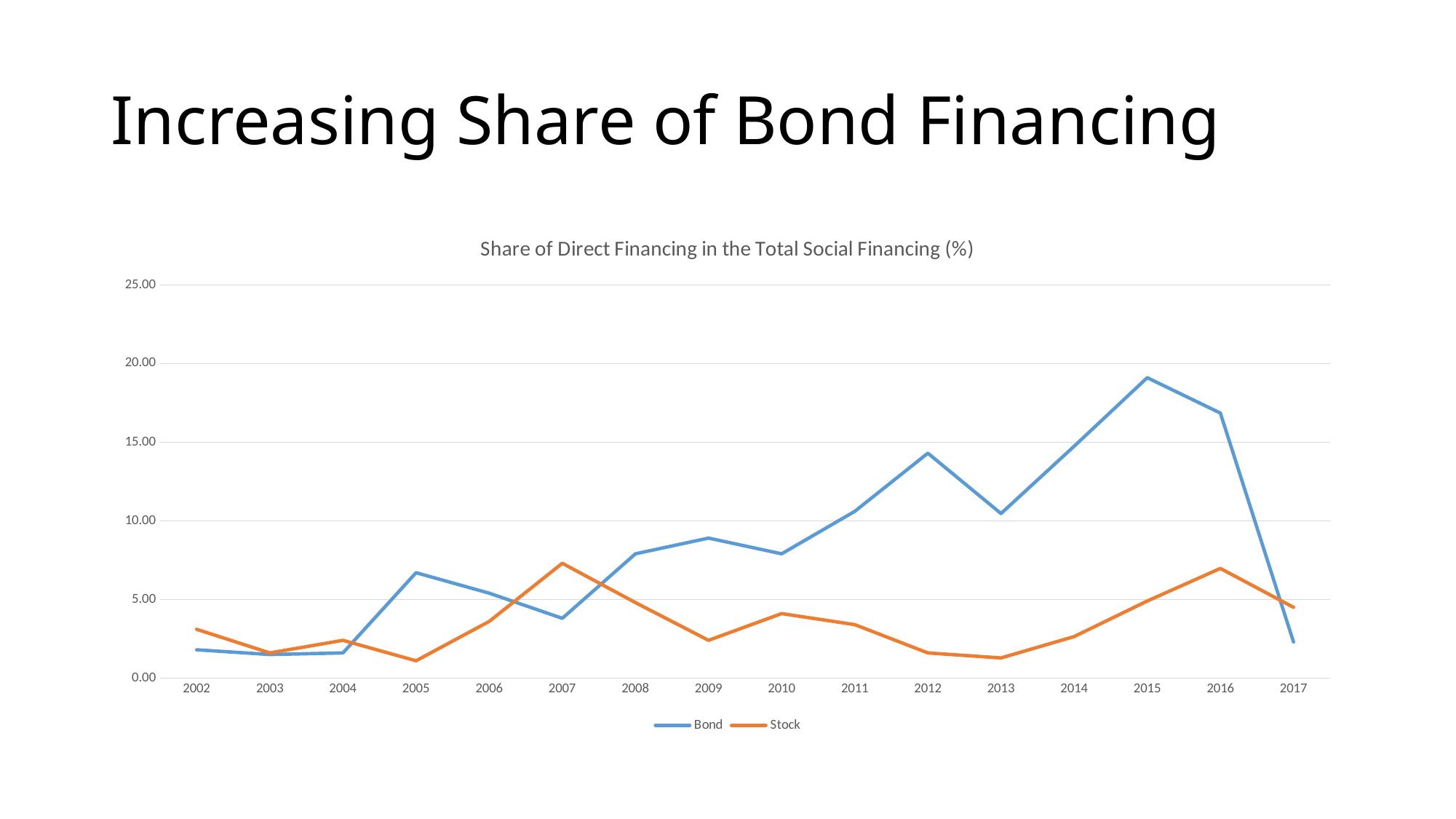
Which series has the larger value in 2015, Bond or Stock? Bond What is the title of the chart? Share of Direct Financing in the Total Social Financing (%) Is the value for Bond in 2017 greater or less than 5.00? less Is the value for Stock in 2007 greater or less than 5.00? greater How many years are plotted along the x axis? 16 How many series does the legend list? 2 What kind of chart is shown on the slide? Line chart In which year does the Bond series reach its highest value? 2015 Does the Bond series rise or fall from 2013 to 2015? Rise Is the value for Bond in 2012 greater or less than 10.00? greater Which series has the larger value in 2002, Bond or Stock? Stock